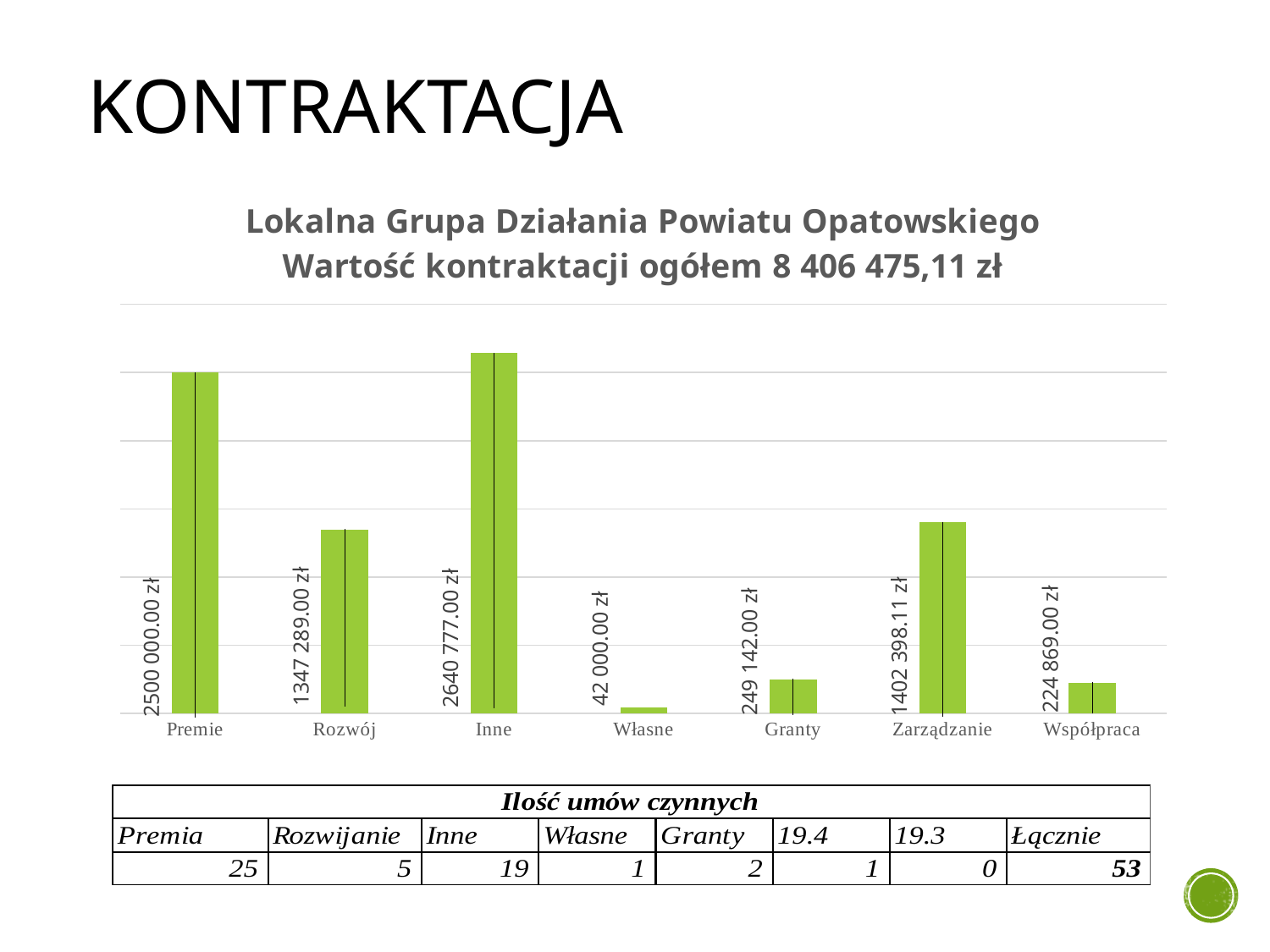
What total contract value is stated in the chart title? 8 406 475,11 zł Which category has the lowest value? Własne What is the difference between the values for Granty and Współpraca? 24 273.00 zł What is the value for Premie? 2500 000.00 zł What is the value for Zarządzanie? 1402 398.11 zł Which category has the highest value? Inne What is the difference between the values for Inne and Premie? 140 777.00 zł Which is larger, the value for Rozwój or the value for Zarządzanie? Zarządzanie How many categories are shown on the x axis? 7 What is the value for Własne? 42 000.00 zł What kind of chart is shown on the slide? Bar chart What is the value for Współpraca? 224 869.00 zł